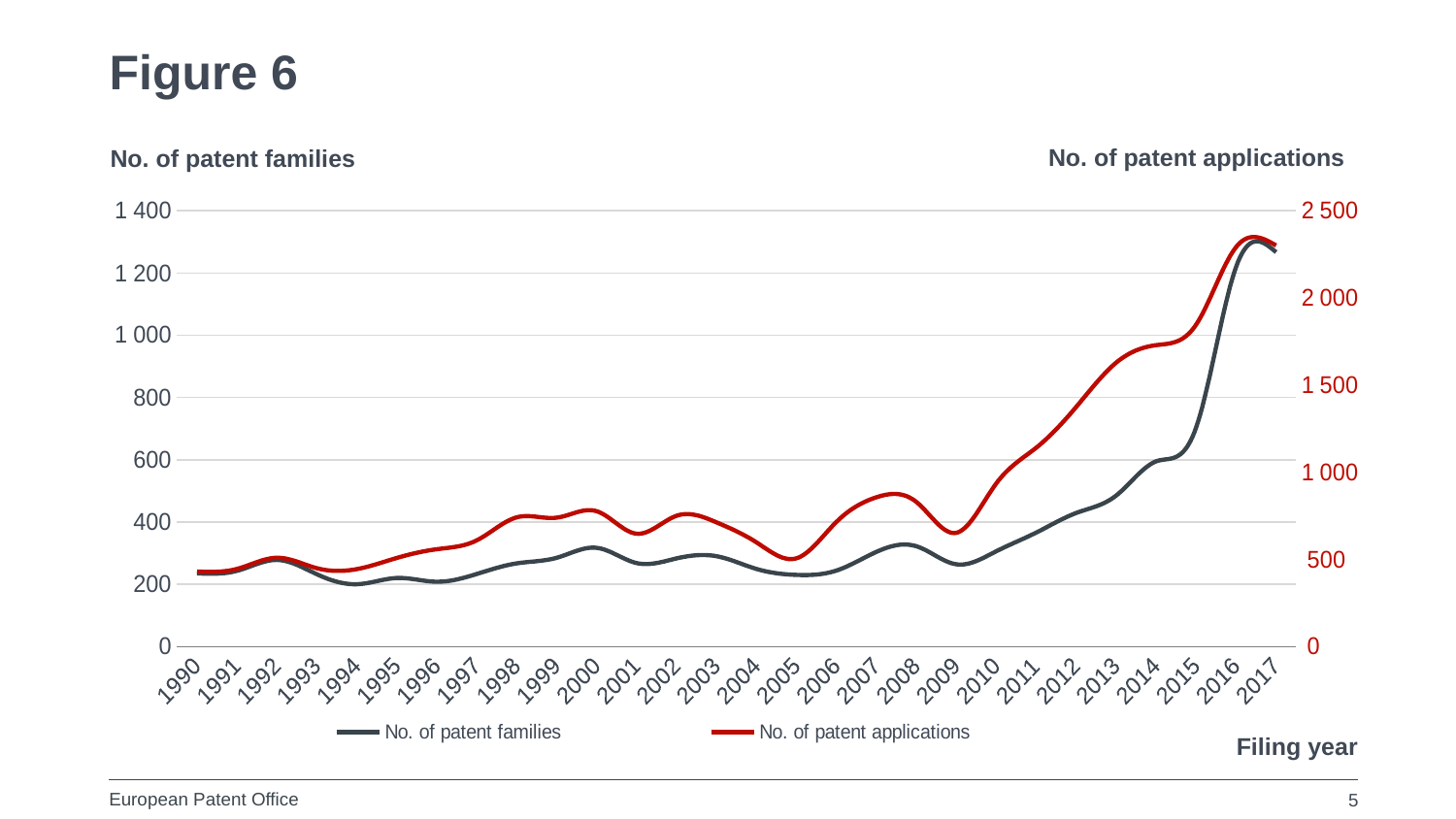
What colour is the line for No. of patent applications? Red Does the No. of patent families line rise or fall between 2009 and 2016? Rise In which filing year does the No. of patent families line reach its highest value? 2017 How many filing years are plotted along the x axis? 28 Is the value for No. of patent applications in 2014 greater or less than 1 500? greater Which is larger for No. of patent families: the value in 2003 or the value in 2013? 2013 Is the value for No. of patent families in 2010 greater or less than 400? less What kind of chart is shown on the slide? Line chart Is the value for No. of patent applications in 2008 greater or less than 500? greater How many series does the legend list? 2 What is the label of the x axis? Filing year